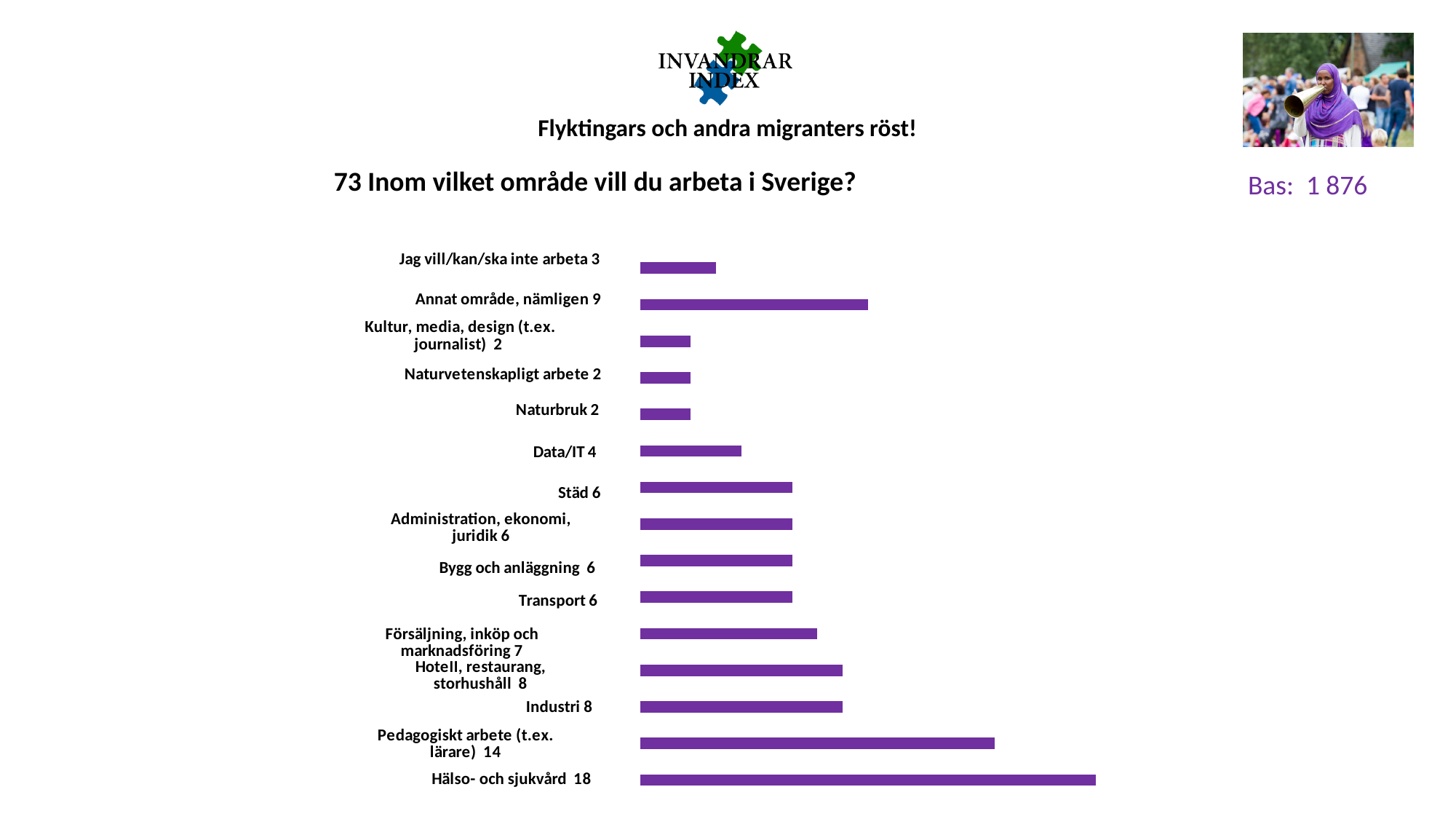
What is the value for Pedagogiskt arbete (t.ex. lärare)? 14 Which is larger, Industri or Försäljning, inköp och marknadsföring? Industri Which category has the highest value? Hälso- och sjukvård How many categories are shown in the chart? 15 What is the difference between Hälso- och sjukvård and Pedagogiskt arbete (t.ex. lärare)? 4 What is the value for Hälso- och sjukvård? 18 What is the difference between Annat område, nämligen and Naturbruk? 7 What is the value for Data/IT? 4 What is the value for Annat område, nämligen? 9 What kind of chart is shown on the slide? Bar chart What is the title of the chart? 73 Inom vilket område vill du arbeta i Sverige? Which is larger, Städ or Jag vill/kan/ska inte arbeta? Städ